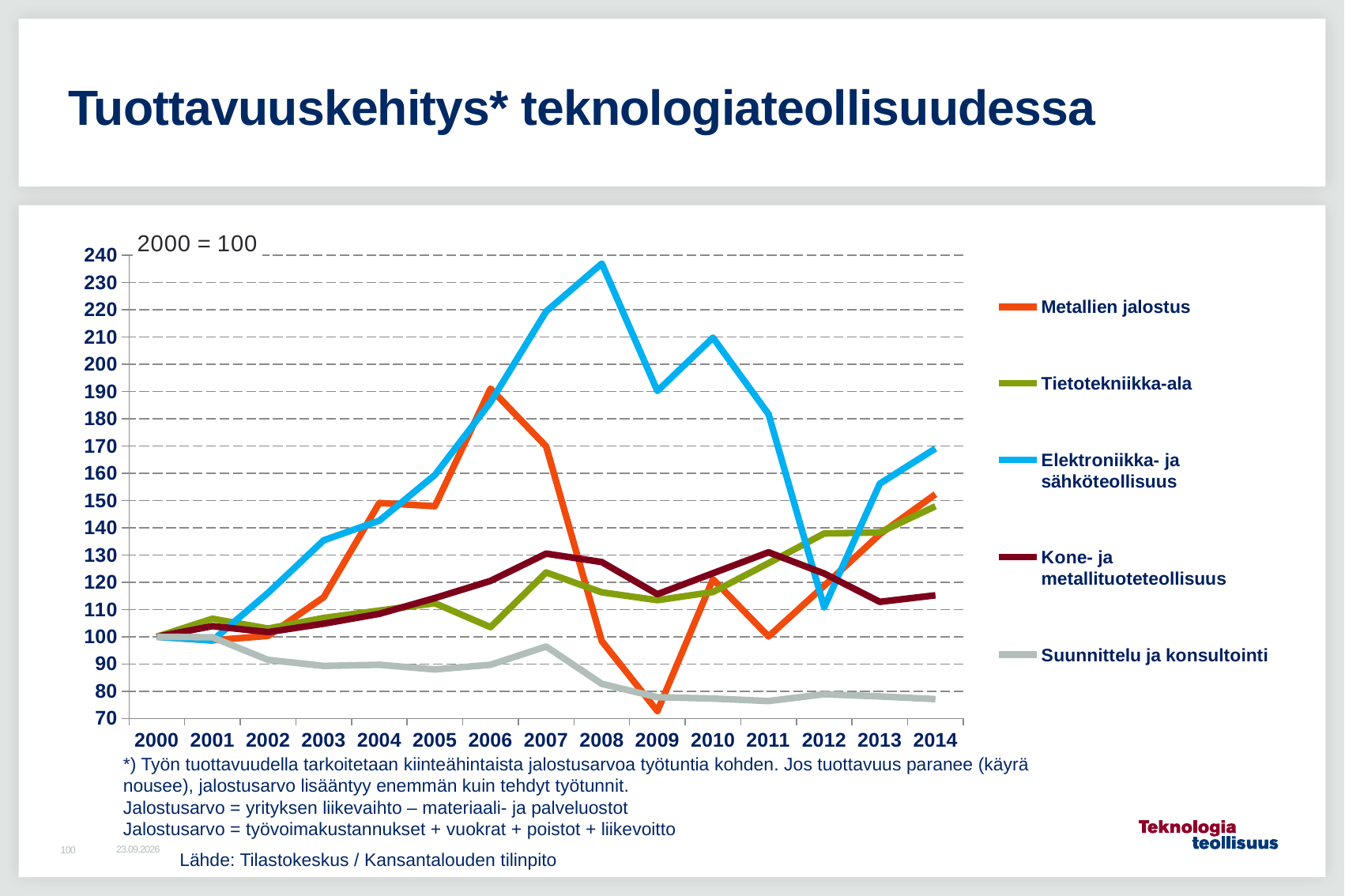
In 2012, which is higher: Tietotekniikka-ala or Elektroniikka- ja sähköteollisuus? Tietotekniikka-ala How many series does the legend list? 5 What kind of chart is shown on the slide? line chart Is the value for Suunnittelu ja konsultointi in 2014 greater or less than 90? less Is the value for Metallien jalostus in 2009 greater or less than 80? less Which series has the lowest value in 2014? Suunnittelu ja konsultointi In 2014, which is higher: Elektroniikka- ja sähköteollisuus or Metallien jalostus? Elektroniikka- ja sähköteollisuus What base year and index value does the chart state? 2000 = 100 Does the Suunnittelu ja konsultointi line rise or fall from 2000 to 2014? fall Which series reaches the highest value on the chart? Elektroniikka- ja sähköteollisuus How many years are shown on the x axis? 15 Is the value for Elektroniikka- ja sähköteollisuus in 2008 greater or less than 220? greater